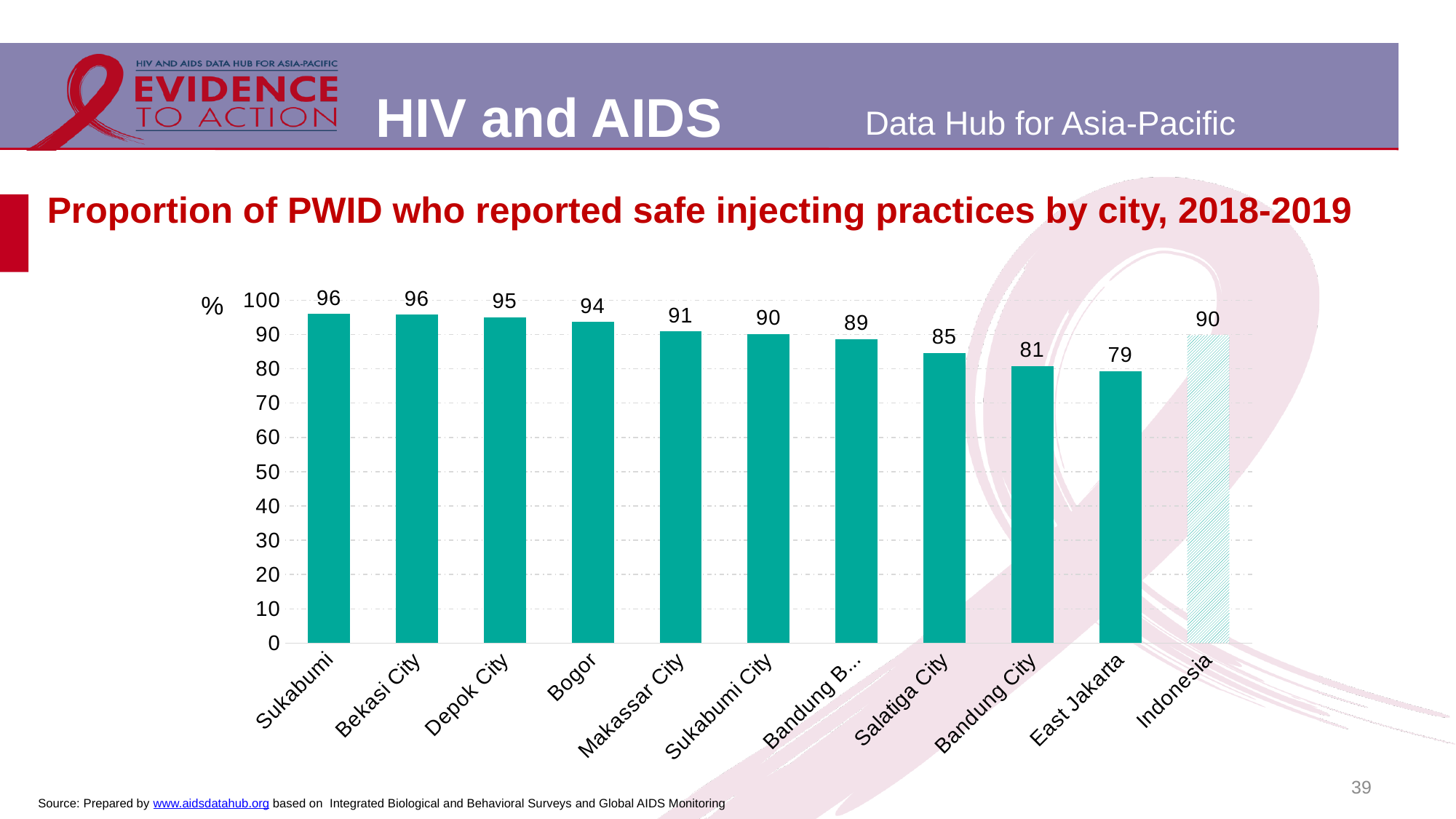
What is the difference between the values for Makassar City and East Jakarta? 12 What is the title of the chart? Proportion of PWID who reported safe injecting practices by city, 2018-2019 What is the value for Salatiga City? 85 What is the value for Indonesia? 90 What is the value for Bogor? 94 Is the value for Bandung City greater or less than 90? less What is the value for East Jakarta? 79 How many categories are shown on the x axis? 11 What is the difference between the values for Depok City and Bandung City? 14 Which category has the lowest value? East Jakarta What kind of chart is shown on the slide? bar chart Which is larger, the value for Sukabumi City or the value for Salatiga City? Sukabumi City